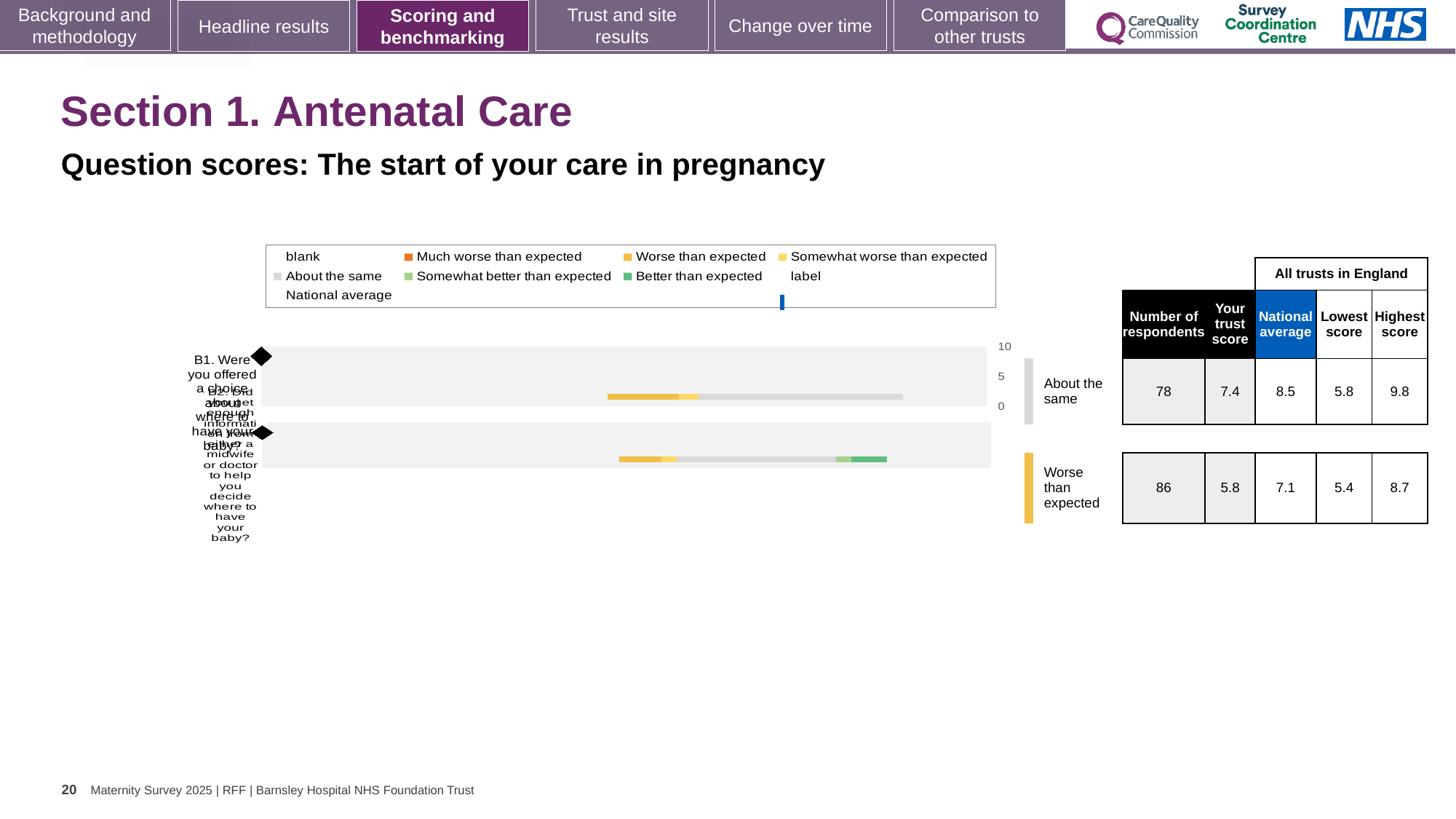
Which legend entry is shown in dark green? Better than expected How many entries does the chart legend list? 9 What is the highest score in England for the question rated 'Worse than expected'? 8.7 What is the number of respondents for the question rated 'About the same'? 78 Which question has the higher trust score, the one rated 'About the same' or the one rated 'Worse than expected'? About the same What is the difference between the national average and the trust score for the question rated 'Worse than expected'? 1.3 What is the trust score for the question rated 'Worse than expected'? 5.8 How many question bars are plotted in the chart? 2 What is the lowest score in England for the question rated 'About the same'? 5.8 What is the national average for the question rated 'About the same'? 8.5 What kind of chart is shown on the slide? bar chart What is the difference between the national average and the trust score for the question rated 'About the same'? 1.1